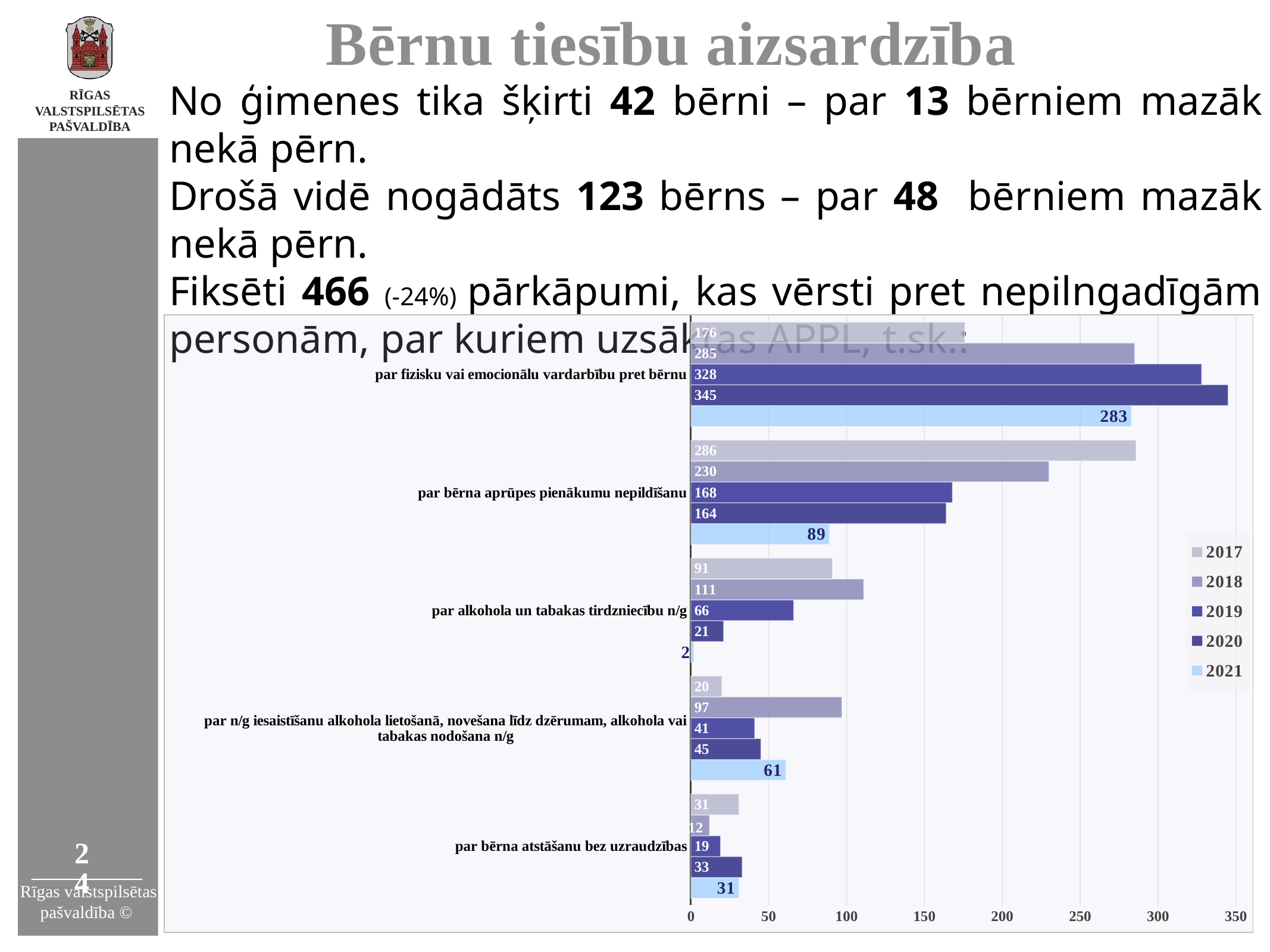
Which series is shown in light blue in the chart legend? 2021 Which year has the highest value for 'par fizisku vai emocionālu vardarbību pret bērnu'? 2020 What is the 2021 value for 'par fizisku vai emocionālu vardarbību pret bērnu'? 283 How many categories are plotted on the chart? 5 What is the 2021 value for 'par alkohola un tabakas tirdzniecību n/g'? 2 Which year has the lowest value for 'par bērna atstāšanu bez uzraudzības'? 2018 What kind of chart is shown on the slide? bar chart What is the 2020 value for 'par bērna aprūpes pienākumu nepildīšanu'? 164 What is the difference between the 2017 and 2021 values for 'par bērna aprūpes pienākumu nepildīšanu'? 197 How many series does the chart legend list? 5 Do the values for 'par bērna aprūpes pienākumu nepildīšanu' rise or fall from 2017 to 2021? fall Which is larger for 'par n/g iesaistīšanu alkohola lietošanā, novešana līdz dzērumam, alkohola vai tabakas nodošana n/g': the 2018 value or the 2021 value? 2018